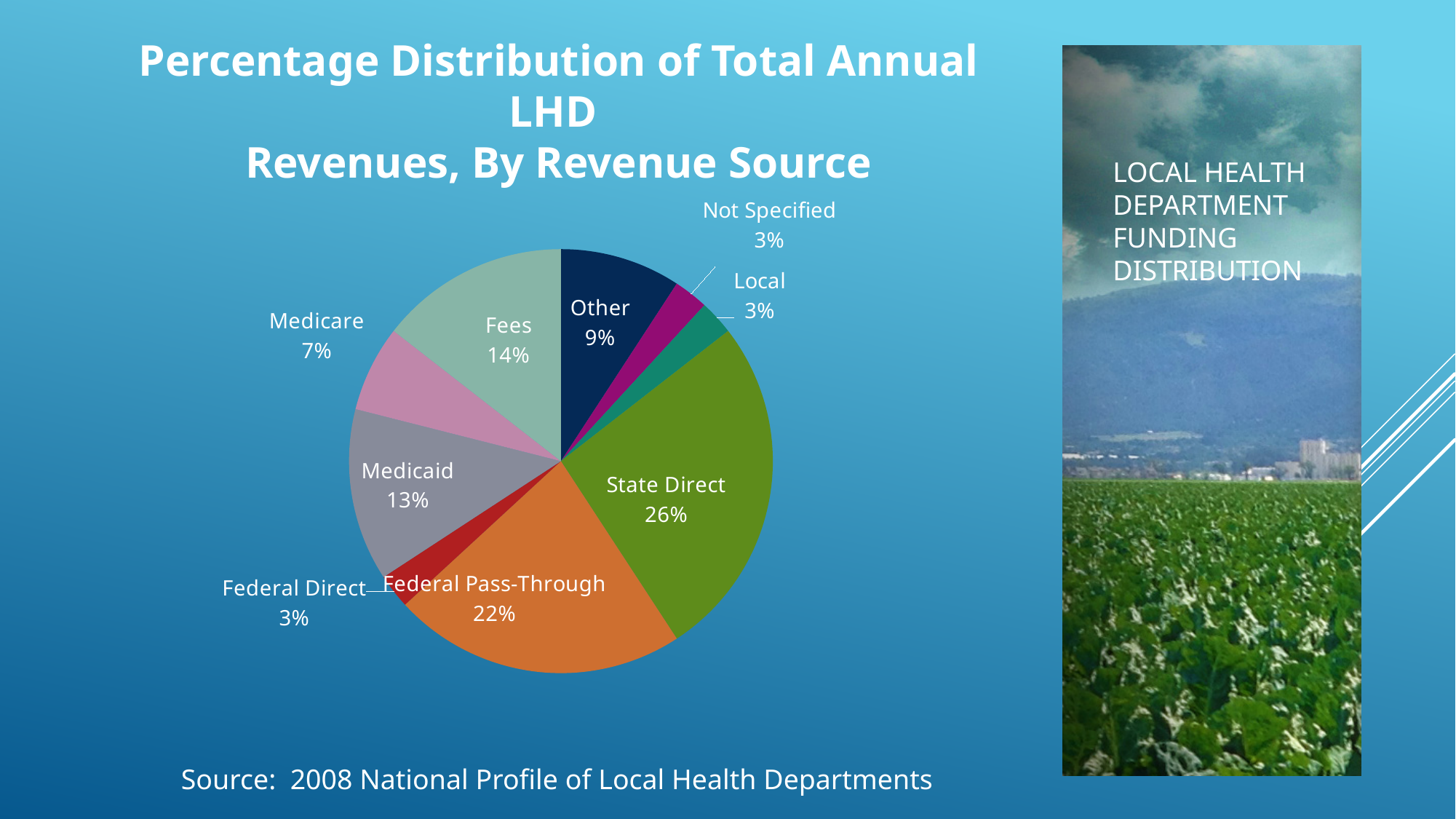
What share of revenues is attributed to Federal Pass-Through? 22% What source is cited below the chart? 2008 National Profile of Local Health Departments What is the combined share of Medicaid and Medicare? 20% How many slices does the pie chart have? 9 What is the difference between the State Direct and Federal Pass-Through shares? 4% What percentage of revenues comes from Fees? 14% What type of chart is shown on the slide? pie chart What percentage is shown for Medicare? 7% What percentage of total annual LHD revenues comes from State Direct? 26% What is the value shown for Medicaid? 13% Which revenue source has the largest share of the pie? State Direct Which is larger, the Fees share or the Medicaid share? Fees